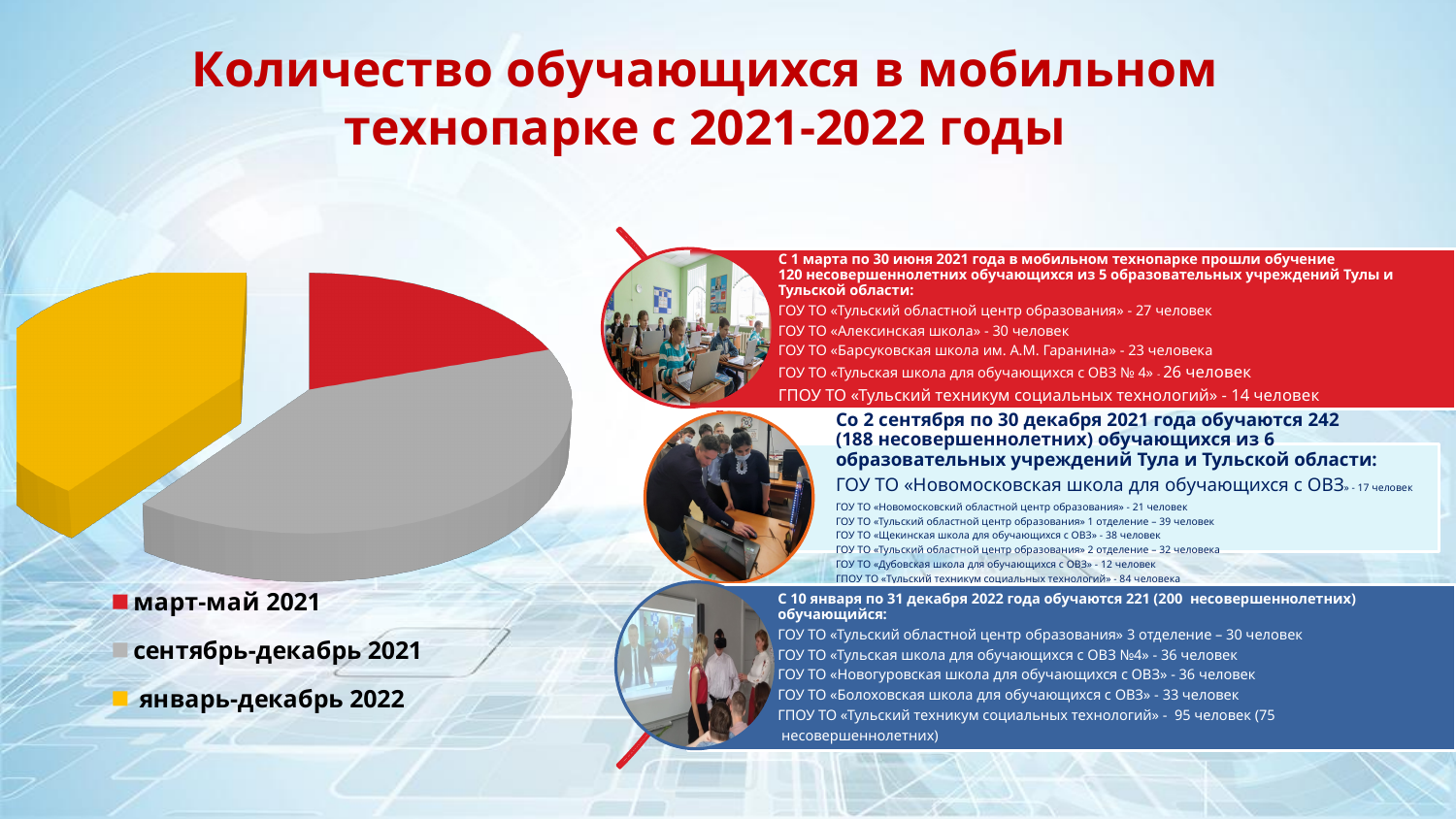
How many entries does the chart legend list? 3 How many slices does the pie chart have? 3 Which slice is larger: январь-декабрь 2022 or март-май 2021? январь-декабрь 2022 What is the title of the slide containing the pie chart? Количество обучающихся в мобильном технопарке с 2021-2022 годы Which category has the smallest slice of the pie chart? март-май 2021 Which colour represents март-май 2021 in the pie chart? Red Which slice is larger: сентябрь-декабрь 2021 or март-май 2021? сентябрь-декабрь 2021 What kind of chart is shown on the slide? Pie chart